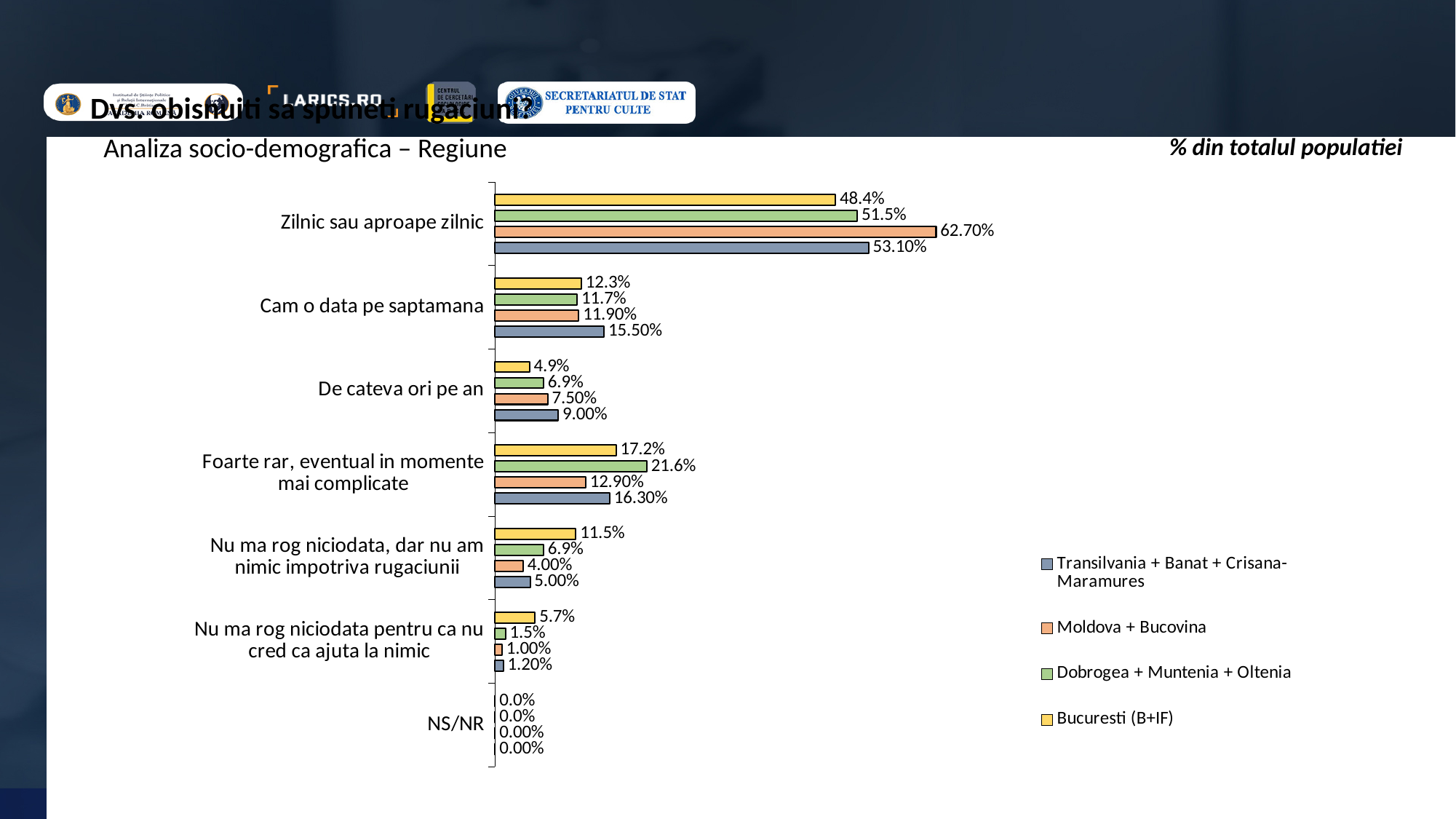
How many series does the legend list? 4 How many response categories are shown on the chart? 7 In the 'De cateva ori pe an' category, which is larger: Transilvania + Banat + Crisana-Maramures or Bucuresti (B+IF)? Transilvania + Banat + Crisana-Maramures What is the value for Moldova + Bucovina in the 'Zilnic sau aproape zilnic' category? 62.70% What is the value for Dobrogea + Muntenia + Oltenia in the 'Foarte rar, eventual in momente mai complicate' category? 21.6% Which region has the highest value in the 'Zilnic sau aproape zilnic' category? Moldova + Bucovina What is the subtitle shown above the chart? Analiza socio-demografica – Regiune What kind of chart is shown on the slide? bar chart Which region has the lowest value in the 'Nu ma rog niciodata pentru ca nu cred ca ajuta la nimic' category? Moldova + Bucovina What is the value for Transilvania + Banat + Crisana-Maramures in the 'Nu ma rog niciodata, dar nu am nimic impotriva rugaciunii' category? 5.00% What is the value for Bucuresti (B+IF) in the 'Cam o data pe saptamana' category? 12.3% What is the difference between Moldova + Bucovina and Bucuresti (B+IF) in the 'Zilnic sau aproape zilnic' category? 14.3%